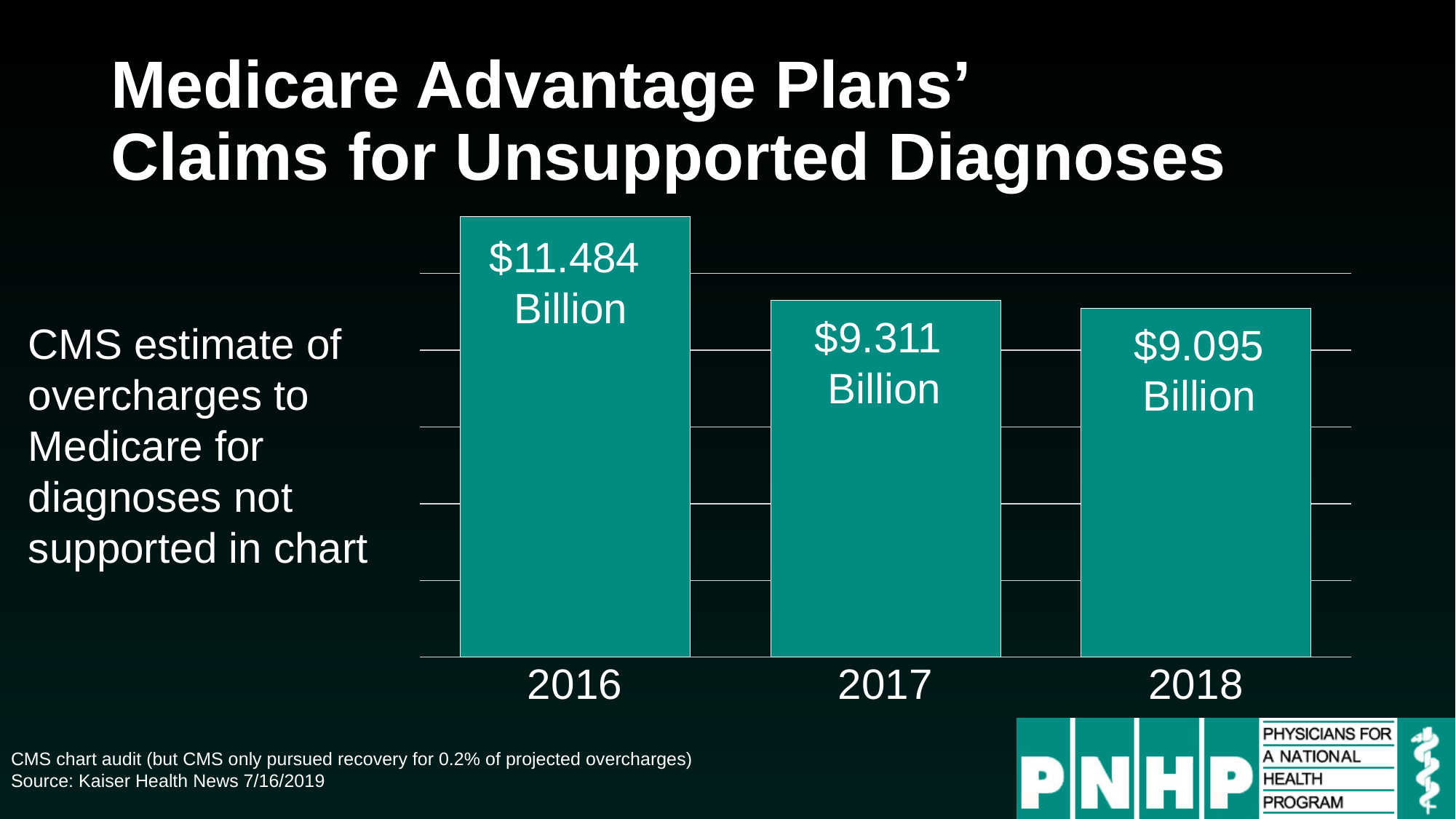
What is the value for 2016? $11.484 Billion What kind of chart is shown on the slide? Bar chart What is the value for 2017? $9.311 Billion What is the value for 2018? $9.095 Billion Do the values rise or fall from 2016 to 2018? Fall What is the difference between the 2016 and 2018 values? $2.389 Billion Which year has the highest value? 2016 Which is larger, the value for 2017 or the value for 2018? 2017 Which year has the lowest value? 2018 What is the difference between the 2017 and 2018 values? $0.216 Billion What is the difference between the 2016 and 2017 values? $2.173 Billion How many years are shown on the chart? 3